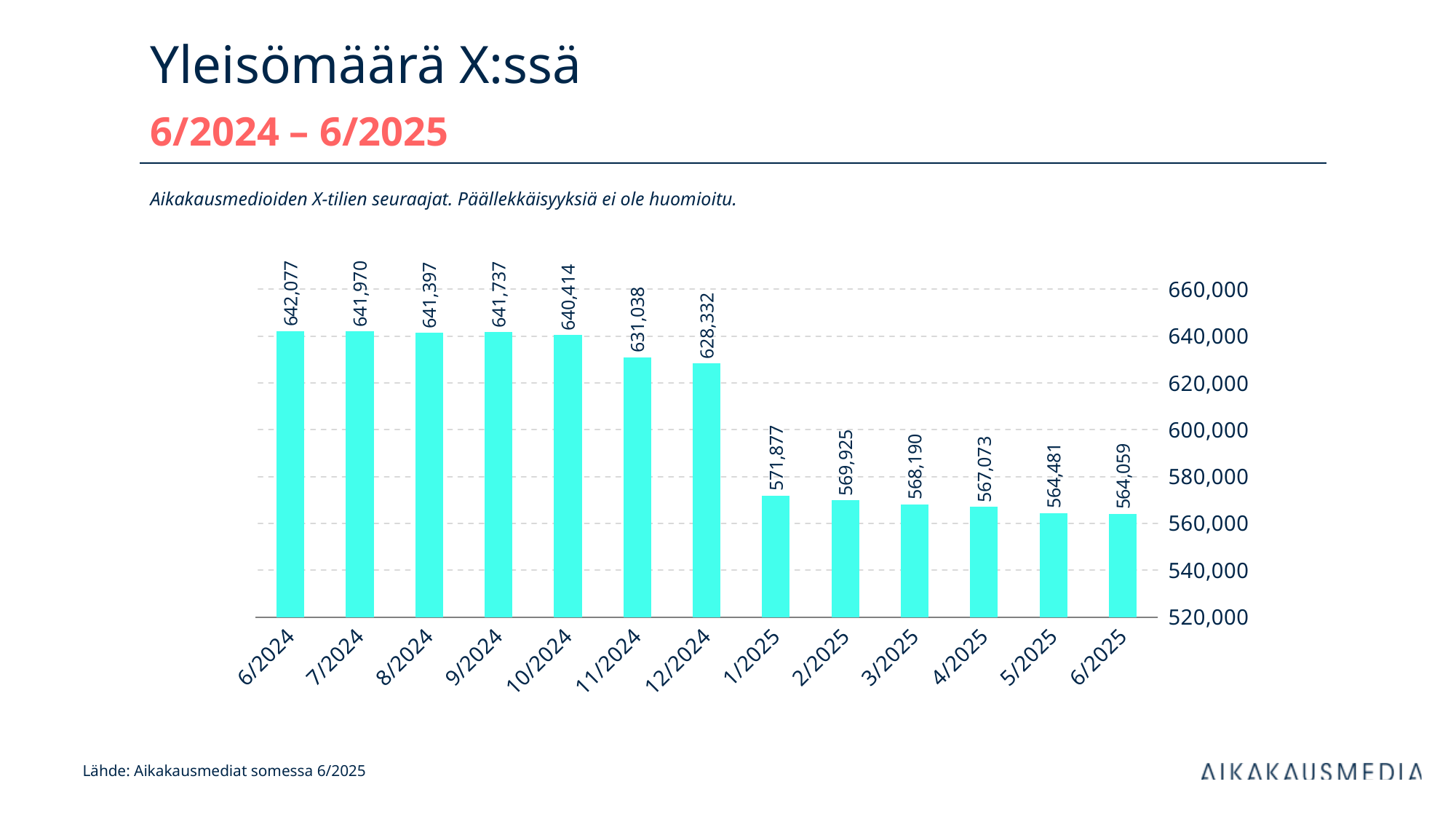
Which month has the highest value? 6/2024 Which month has the lowest value? 6/2025 What is the difference between the values for 6/2024 and 6/2025? 78,018 Is the value for 1/2025 greater or less than 580,000? less Which is larger, the value for 10/2024 or the value for 2/2025? 10/2024 How many months are shown on the x axis? 13 What kind of chart is shown on the slide? bar chart What is the value for 12/2024? 628,332 Do the values rise or fall from 6/2024 to 6/2025? fall What is the value for 6/2024? 642,077 What is the value for 6/2025? 564,059 What is the difference between the values for 12/2024 and 1/2025? 56,455